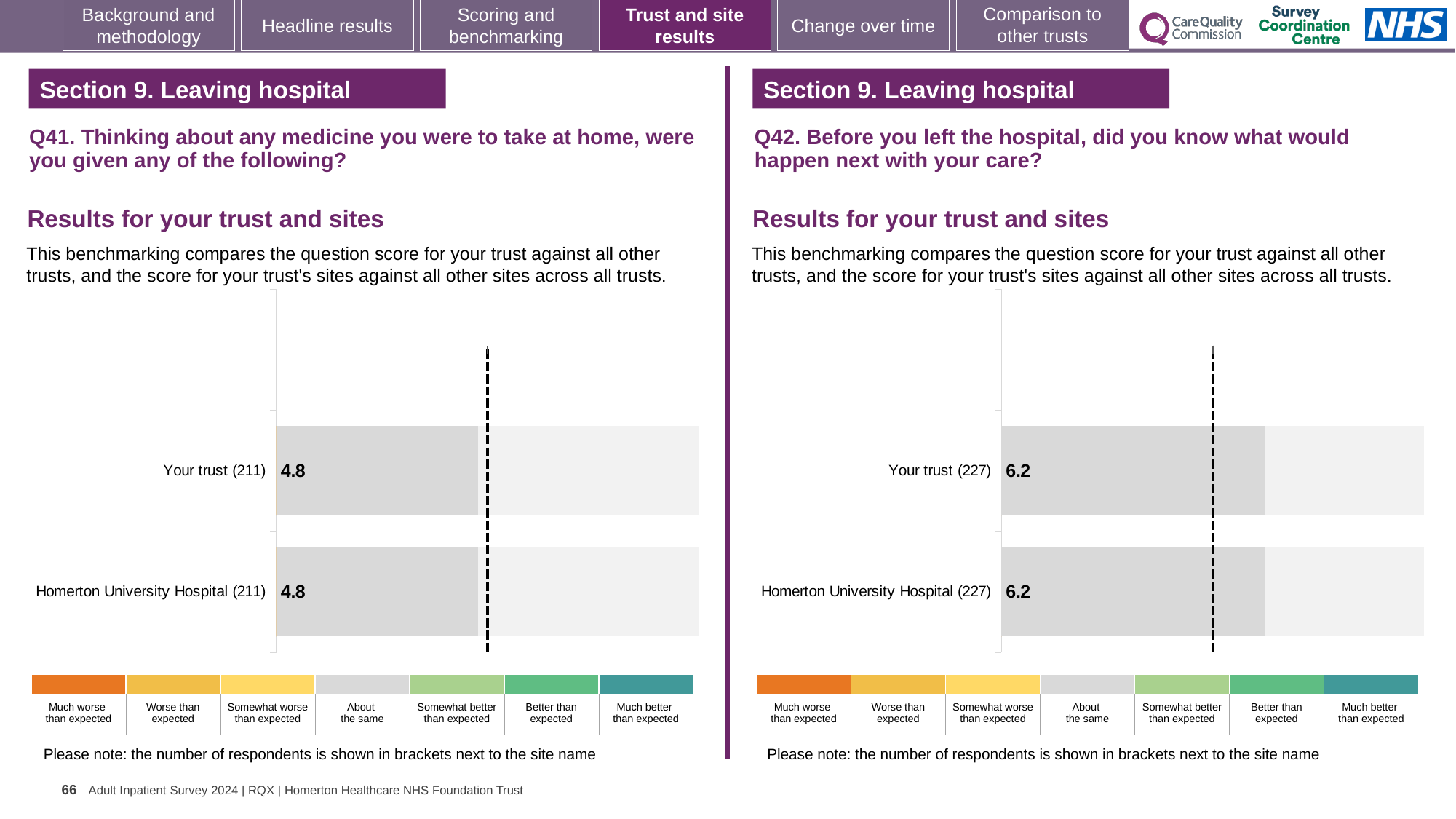
On the Q41 chart (left), how many respondents are shown in brackets next to Your trust? 211 What kind of chart is used on the Q41 chart (left)? Bar chart On the Q42 chart (right), what is the score for Homerton University Hospital? 6.2 Is the score for Your trust on the Q42 chart (right) larger or smaller than the score for Your trust on the Q41 chart (left)? Larger On the Q42 chart (right), how many respondents are shown in brackets next to Homerton University Hospital? 227 On the Q42 chart (right), what is the score for Your trust? 6.2 How many bars are plotted on the Q41 chart (left)? 2 How many bars are plotted on the Q42 chart (right)? 2 On the Q41 chart (left), what is the score for Homerton University Hospital? 4.8 On the Q42 chart (right), what is the difference between the score for Your trust and the score for Homerton University Hospital? 0.0 On the Q41 chart (left), what is the difference between the score for Your trust and the score for Homerton University Hospital? 0.0 On the Q41 chart (left), what is the score for Your trust? 4.8